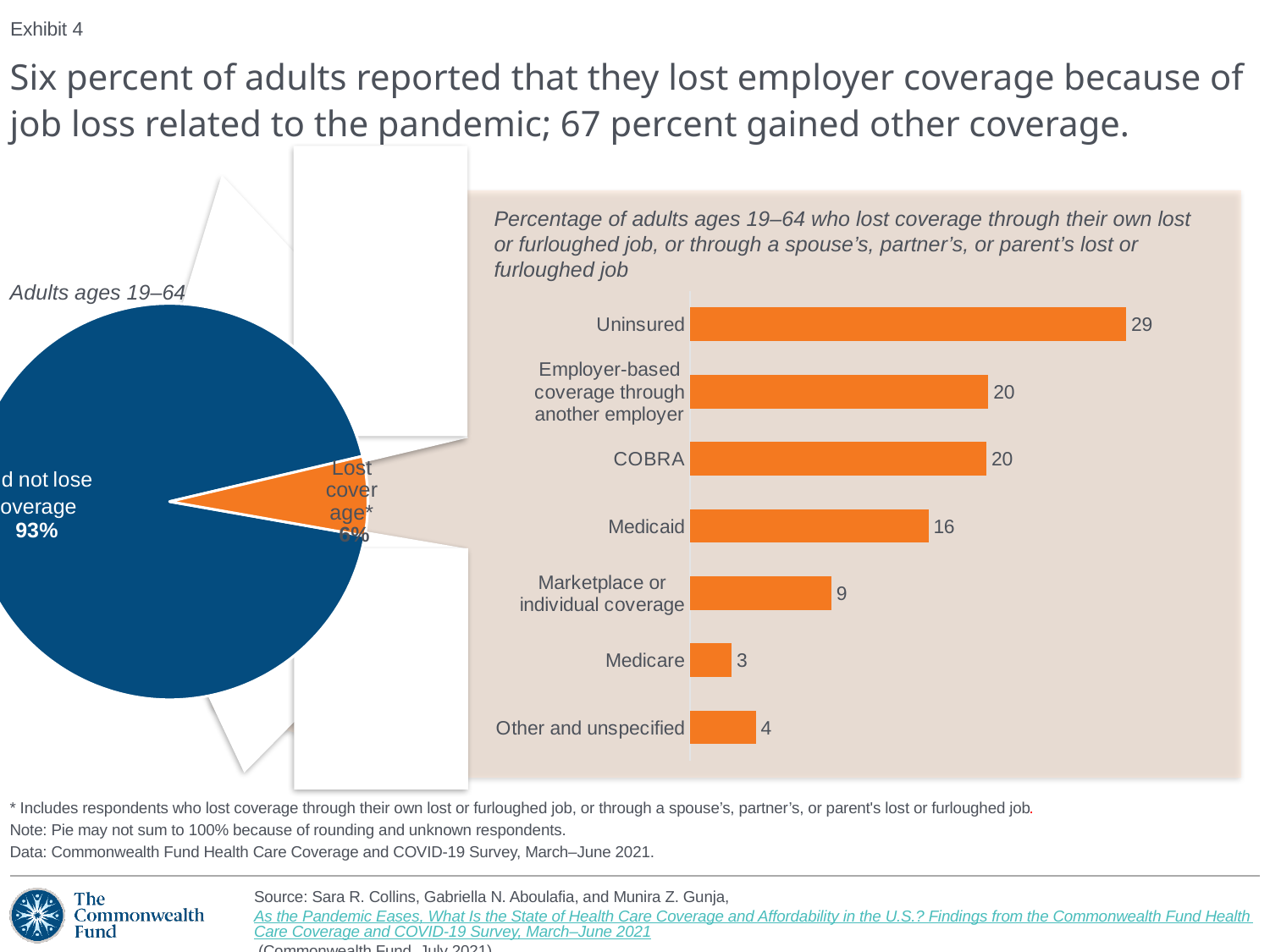
What kind of chart is shown on the right side of the slide? Bar chart In the pie chart on the left, what share of adults ages 19–64 did not lose coverage? 93% In the bar chart on the right, what is the value for Uninsured? 29 In the bar chart on the right, what is the value for COBRA? 20 In the bar chart on the right, what is the difference between the values for Uninsured and Medicaid? 13 How many categories are shown in the bar chart on the right? 7 In the bar chart on the right, what is the value for Medicaid? 16 What kind of chart is shown on the left side of the slide? Pie chart In the bar chart on the right, which category has the lowest value? Medicare In the bar chart on the right, which category has the highest value? Uninsured In the bar chart on the right, which is larger: the value for Medicare or the value for Other and unspecified? Other and unspecified In the bar chart on the right, what is the value for Marketplace or individual coverage? 9